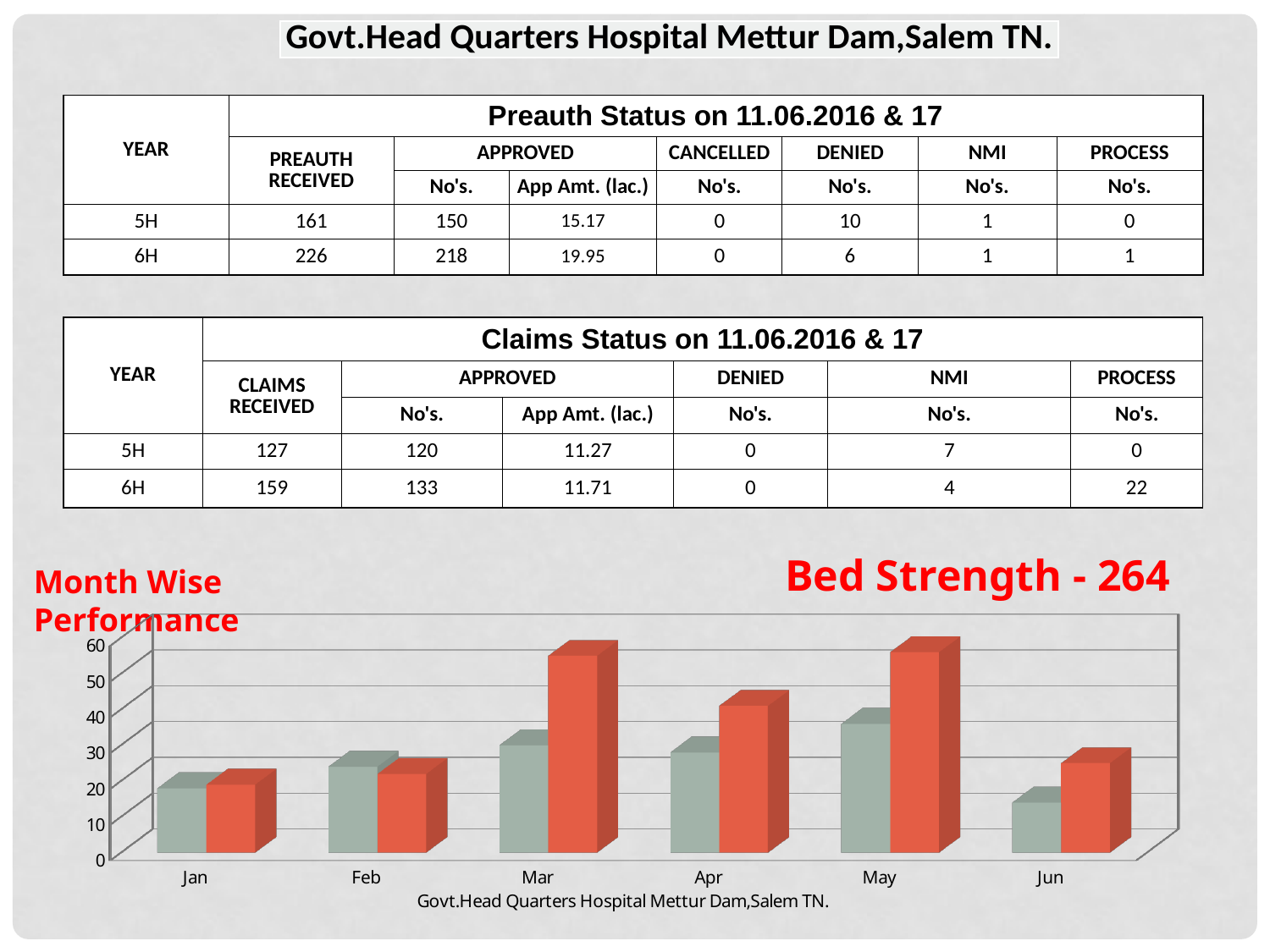
In the bar chart, which month has the shortest grey bar? Jun What kind of chart is shown at the bottom of the slide? bar chart In the bar chart, is the grey bar for Jun greater or less than 20? less In the bar chart, which month has the tallest grey bar? May What text appears below the x axis of the bar chart? Govt.Head Quarters Hospital Mettur Dam,Salem TN. What is the title shown in red above the bar chart on the left? Month Wise Performance In the bar chart, is the red bar for Apr greater or less than 30? greater How many months are shown on the x axis of the bar chart? 6 In the bar chart, is the grey bar for Jan greater or less than 30? less In the bar chart, which is taller for Mar: the grey bar or the red bar? the red bar How many bars are plotted for each month in the bar chart? 2